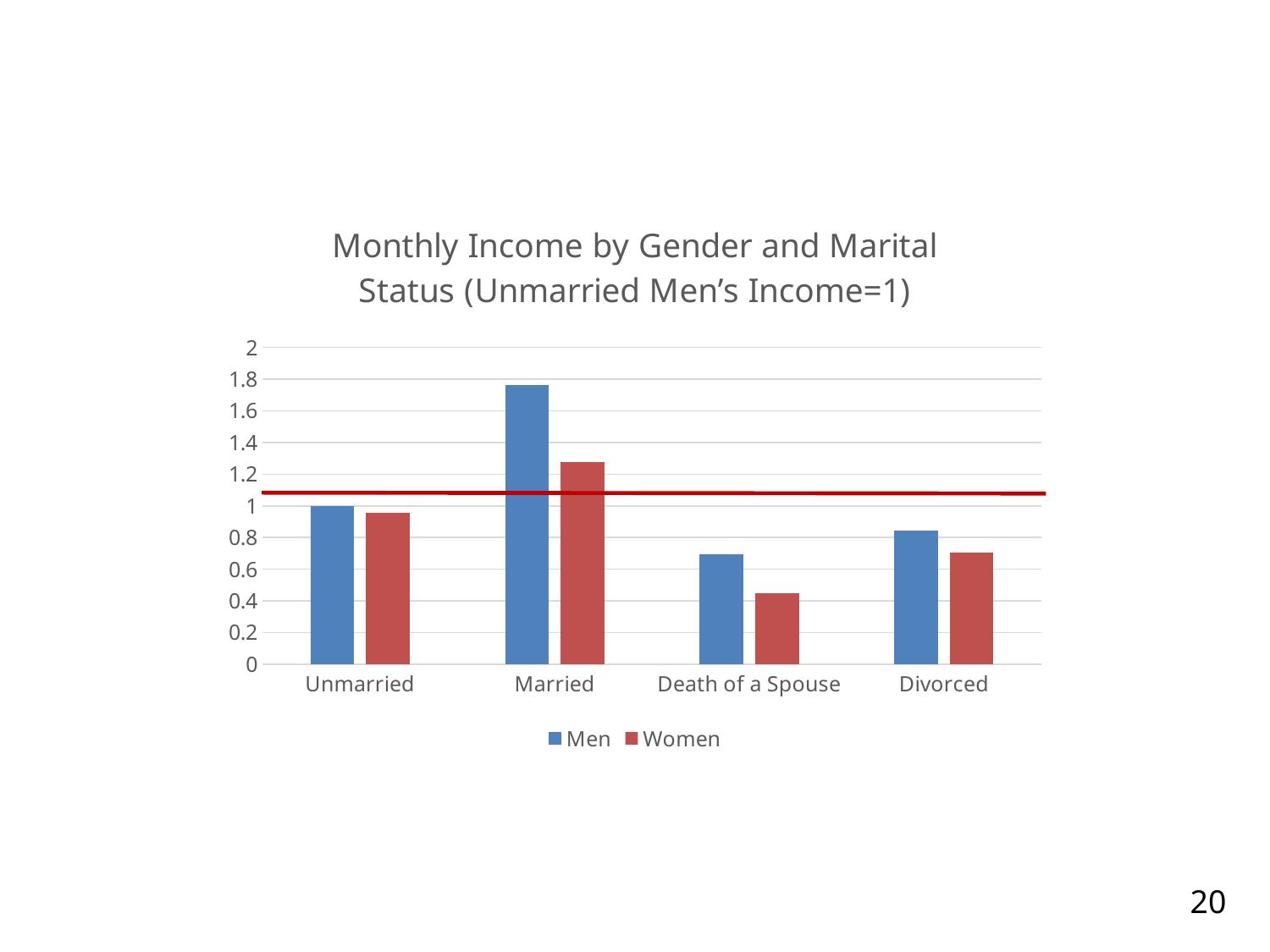
Is the value for Women in the Death of a Spouse category greater or less than 0.6? less Is the value for Men in the Married category greater or less than 1.6? greater Which is larger, the value for Men in the Divorced category or the value for Men in the Death of a Spouse category? Divorced What is the title of the chart? Monthly Income by Gender and Marital Status (Unmarried Men's Income=1) What kind of chart is shown on the slide? bar chart In which category is the value for Women lowest? Death of a Spouse What is the value for Men in the Unmarried category? 1 In the Married category, which is larger, the value for Men or the value for Women? Men What colour are the bars for the Women series? red How many marital status categories are shown on the x axis? 4 How many series does the legend list? 2 In which category is the value for Men highest? Married